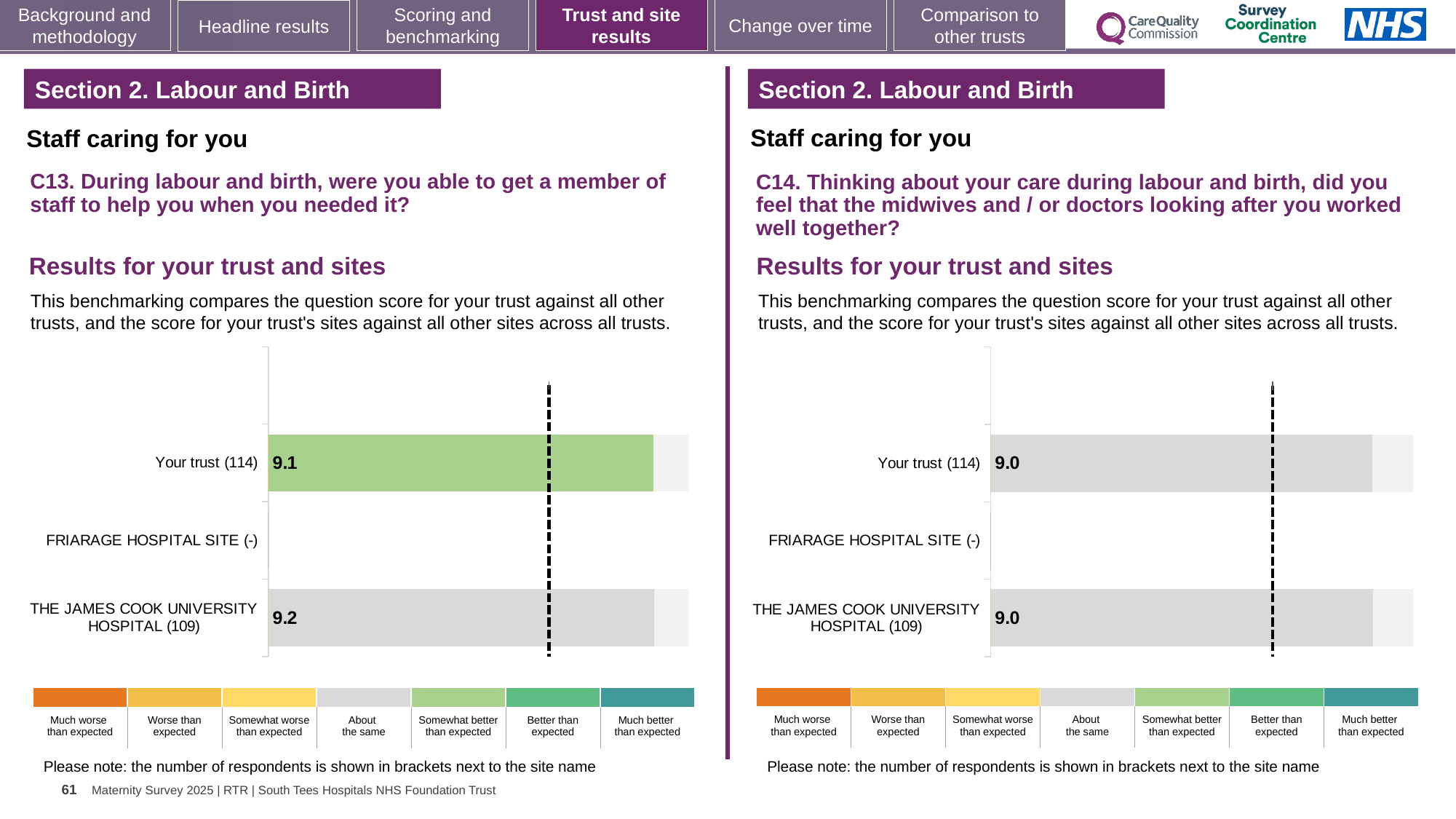
On the C13 chart (left), which category has no bar plotted? FRIARAGE HOSPITAL SITE (-) On the C13 chart (left), what is the score for Your trust (114)? 9.1 What kind of chart is the C14 chart (right)? Bar chart How many categories (rows) are listed on the C13 chart (left)? 3 On the C13 chart (left), what colour is the bar for Your trust (114)? Green On the C13 chart (left), what is the score for THE JAMES COOK UNIVERSITY HOSPITAL (109)? 9.2 On the C14 chart (right), what is the score for THE JAMES COOK UNIVERSITY HOSPITAL (109)? 9.0 On the C13 chart (left), what is the difference between the score for THE JAMES COOK UNIVERSITY HOSPITAL (109) and the score for Your trust (114)? 0.1 On the C13 chart (left), which has the higher score: Your trust (114) or THE JAMES COOK UNIVERSITY HOSPITAL (109)? THE JAMES COOK UNIVERSITY HOSPITAL (109) How many respondents are shown in brackets for Your trust on the C14 chart (right)? 114 On the C14 chart (right), what is the score for Your trust (114)? 9.0 On the C14 chart (right), what is the difference between the score for Your trust (114) and the score for THE JAMES COOK UNIVERSITY HOSPITAL (109)? 0.0